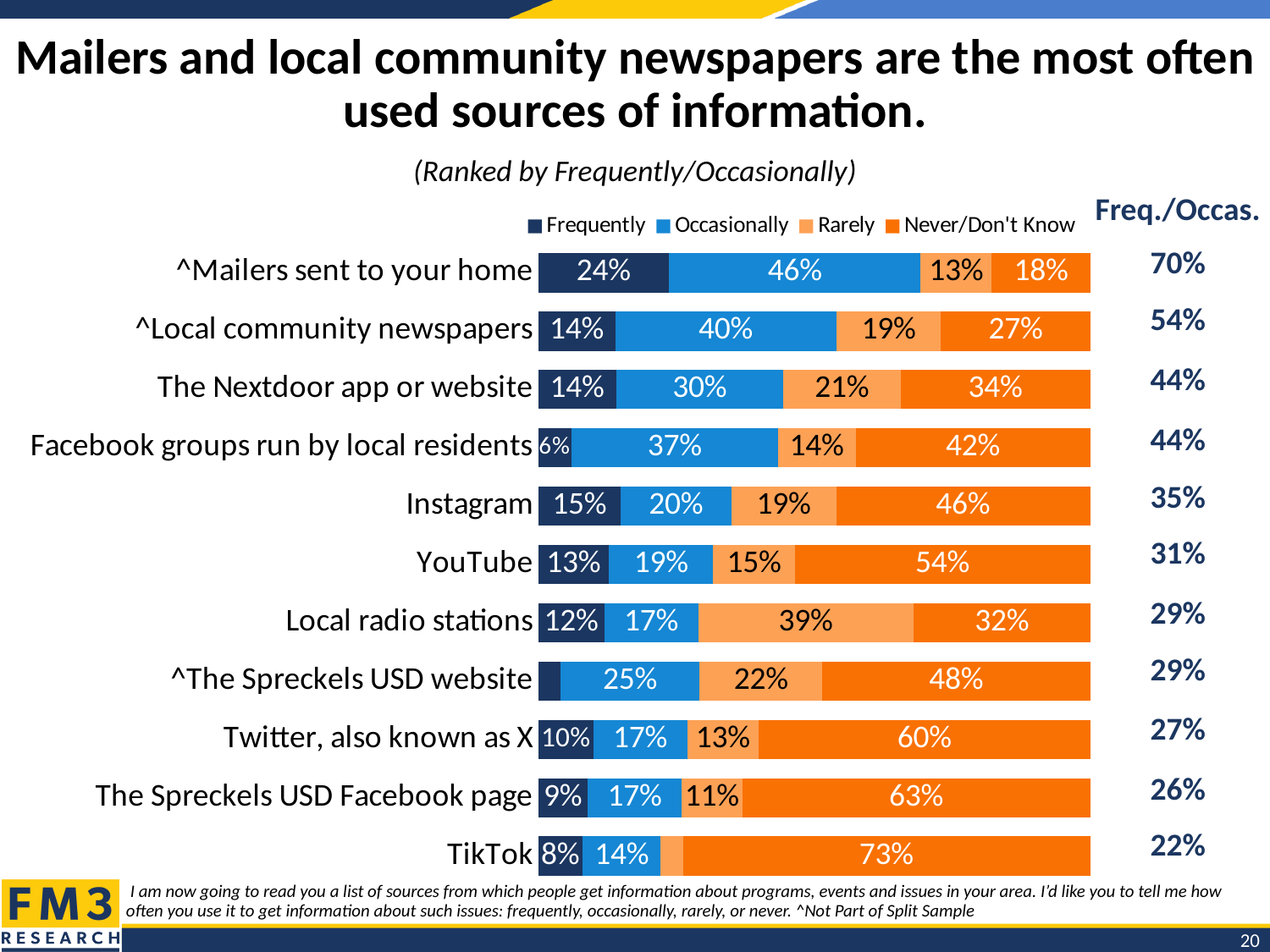
What is the difference between the Occasionally percentages for mailers sent to your home and local community newspapers? 6% What percentage of respondents say they use mailers sent to their home frequently? 24% Which has a larger Never/Don't Know percentage, YouTube or Instagram? YouTube What is the Never/Don't Know percentage for TikTok? 73% Which legend entry is shown in dark navy blue? Frequently What is the Rarely percentage for local radio stations? 39% What is the combined Frequently/Occasionally figure shown for the Nextdoor app or website? 44% What type of chart is shown on the slide? Stacked bar chart How many information sources are listed in the chart? 11 Which source has the lowest Frequently/Occasionally figure? TikTok Which source has the highest Frequently/Occasionally figure? ^Mailers sent to your home How many series does the legend list? 4